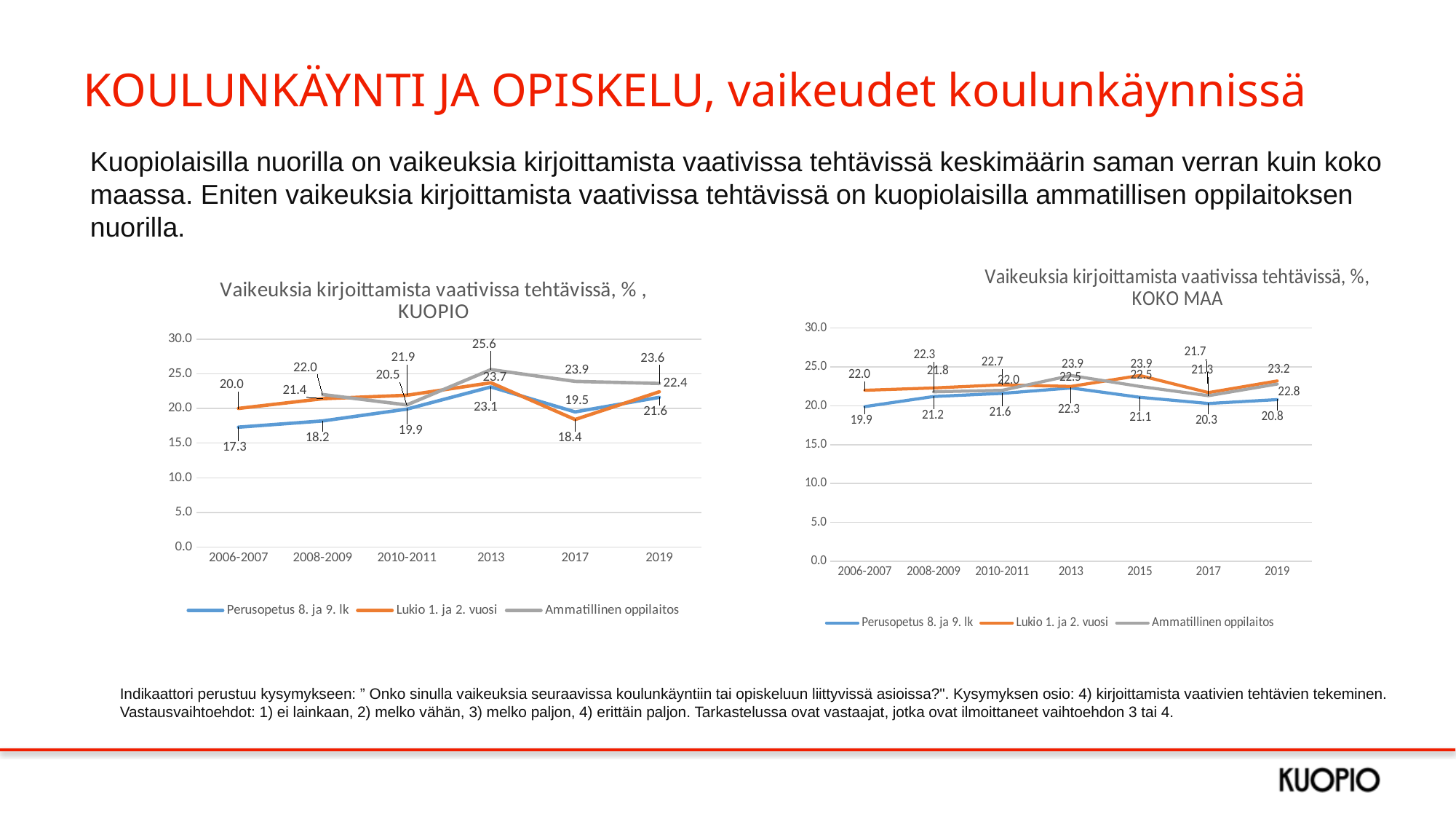
In the KOKO MAA chart, what is the value for Lukio 1. ja 2. vuosi in 2015? 23.9 How many series does the legend of the KOKO MAA chart list? 3 In the KUOPIO chart, in which year is the Lukio 1. ja 2. vuosi value lowest? 2017 In the KUOPIO chart, what is the value for Ammatillinen oppilaitos in 2013? 25.6 How many time periods are shown on the x axis of the KOKO MAA chart? 7 What kind of chart is the KUOPIO chart? Line chart In the KUOPIO chart, what is the difference between the Perusopetus 8. ja 9. lk values in 2019 and 2006-2007? 4.3 In the KOKO MAA chart, what is the value for Perusopetus 8. ja 9. lk in 2006-2007? 19.9 In the KUOPIO chart, in which year does Perusopetus 8. ja 9. lk reach its highest value? 2013 How many time periods are shown on the x axis of the KUOPIO chart? 6 In the KOKO MAA chart, which is larger in 2019: Lukio 1. ja 2. vuosi or Perusopetus 8. ja 9. lk? Lukio 1. ja 2. vuosi In the KUOPIO chart, what is the value for Perusopetus 8. ja 9. lk in 2006-2007? 17.3